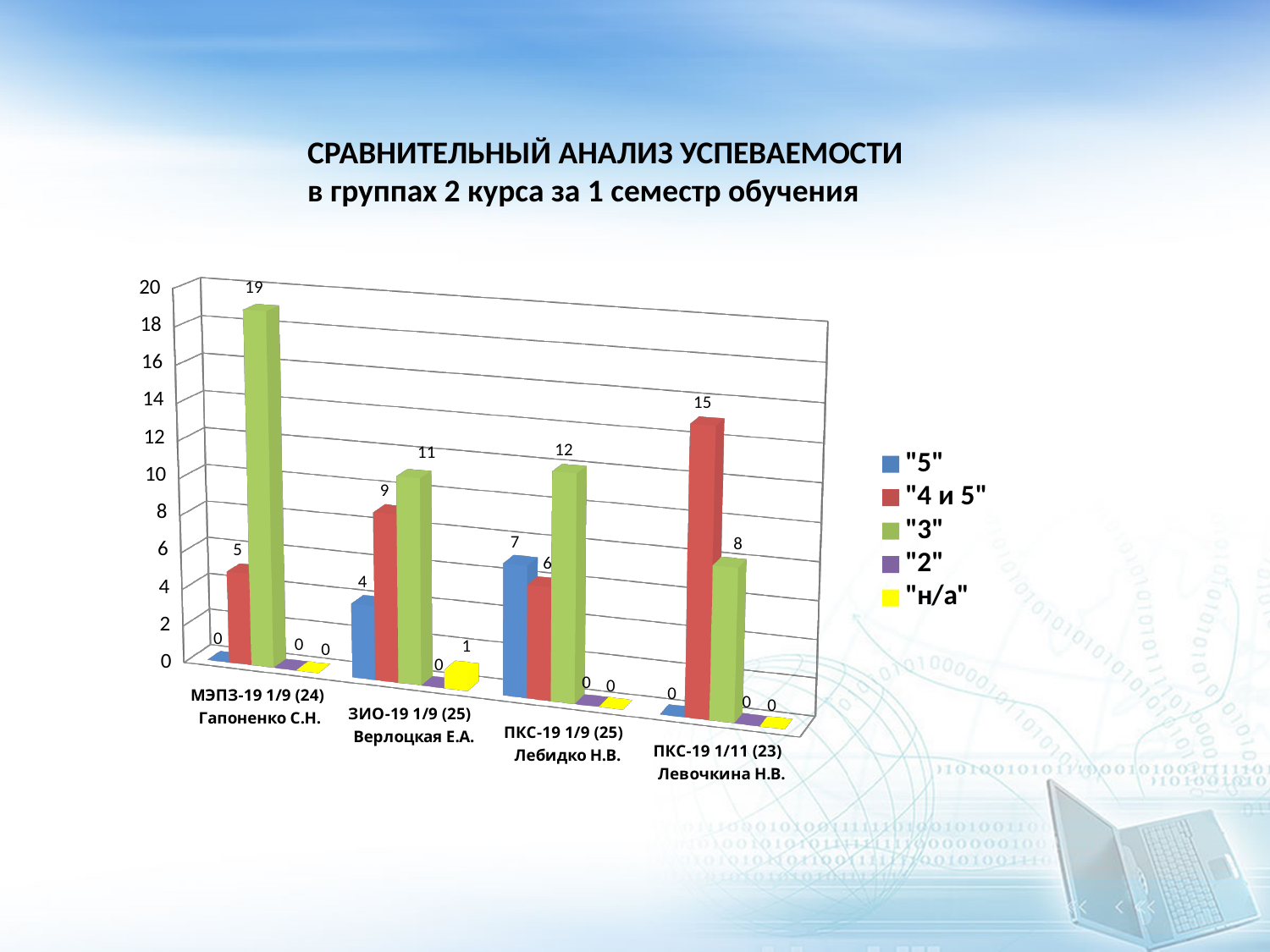
What is the value of "н/а" for ЗИО-19 1/9 (25) Верлоцкая Е.А.? 1 What is the title of the chart on the slide? СРАВНИТЕЛЬНЫЙ АНАЛИЗ УСПЕВАЕМОСТИ в группах 2 курса за 1 семестр обучения Which group has the highest value for "3"? МЭПЗ-19 1/9 (24) Гапоненко С.Н. What is the value of "4 и 5" for ПКС-19 1/11 (23) Левочкина Н.В.? 15 What is the value of "3" for МЭПЗ-19 1/9 (24) Гапоненко С.Н.? 19 What kind of chart is shown on the slide? bar chart How many groups (categories) are shown on the x axis? 4 What is the difference between the "4 и 5" values for ПКС-19 1/11 (23) Левочкина Н.В. and ЗИО-19 1/9 (25) Верлоцкая Е.А.? 6 Which group has the lowest value for "3"? ПКС-19 1/11 (23) Левочкина Н.В. How many series does the legend list? 5 What is the value of "5" for ПКС-19 1/9 (25) Лебидко Н.В.? 7 Which is larger for ПКС-19 1/9 (25) Лебидко Н.В.: the "5" value or the "4 и 5" value? "5"